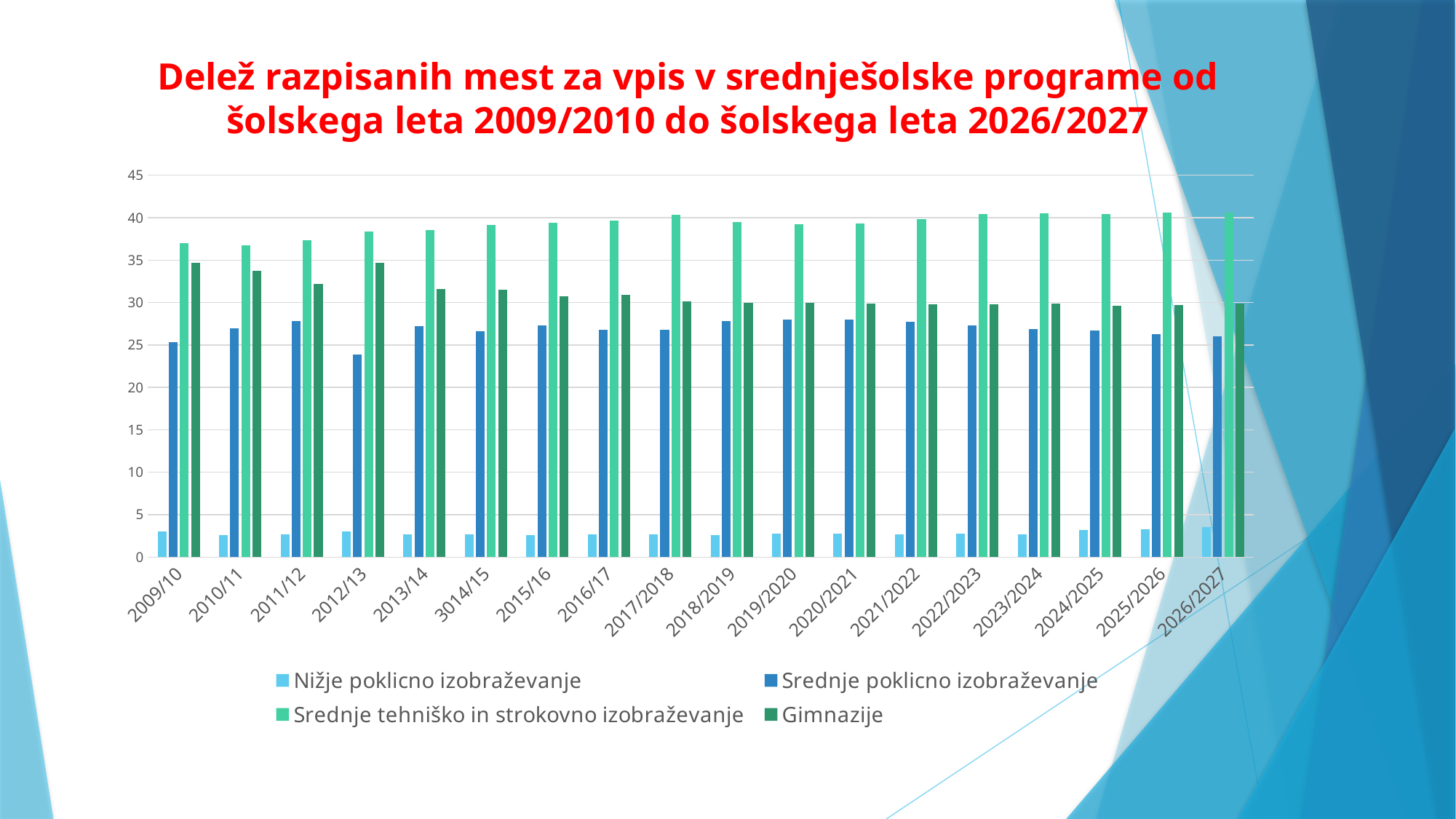
Is the value for Srednje tehniško in strokovno izobraževanje in 2017/2018 greater or less than 35? greater Do the values for Srednje tehniško in strokovno izobraževanje generally rise or fall from 2009/10 to 2026/2027? rise Is the value for Gimnazije in 2009/10 greater or less than 30? greater In 2009/10, which is larger: Srednje tehniško in strokovno izobraževanje or Gimnazije? Srednje tehniško in strokovno izobraževanje Is the value for Nižje poklicno izobraževanje in 2026/2027 greater or less than 5? less Do the values for Gimnazije generally rise or fall from 2009/10 to 2026/2027? fall Which series is shown in dark green in the legend? Gimnazije In which school year is the value for Srednje poklicno izobraževanje lowest? 2012/13 How many series does the legend list? 4 How many school-year categories are shown on the x axis? 18 What kind of chart is shown on the slide? bar chart